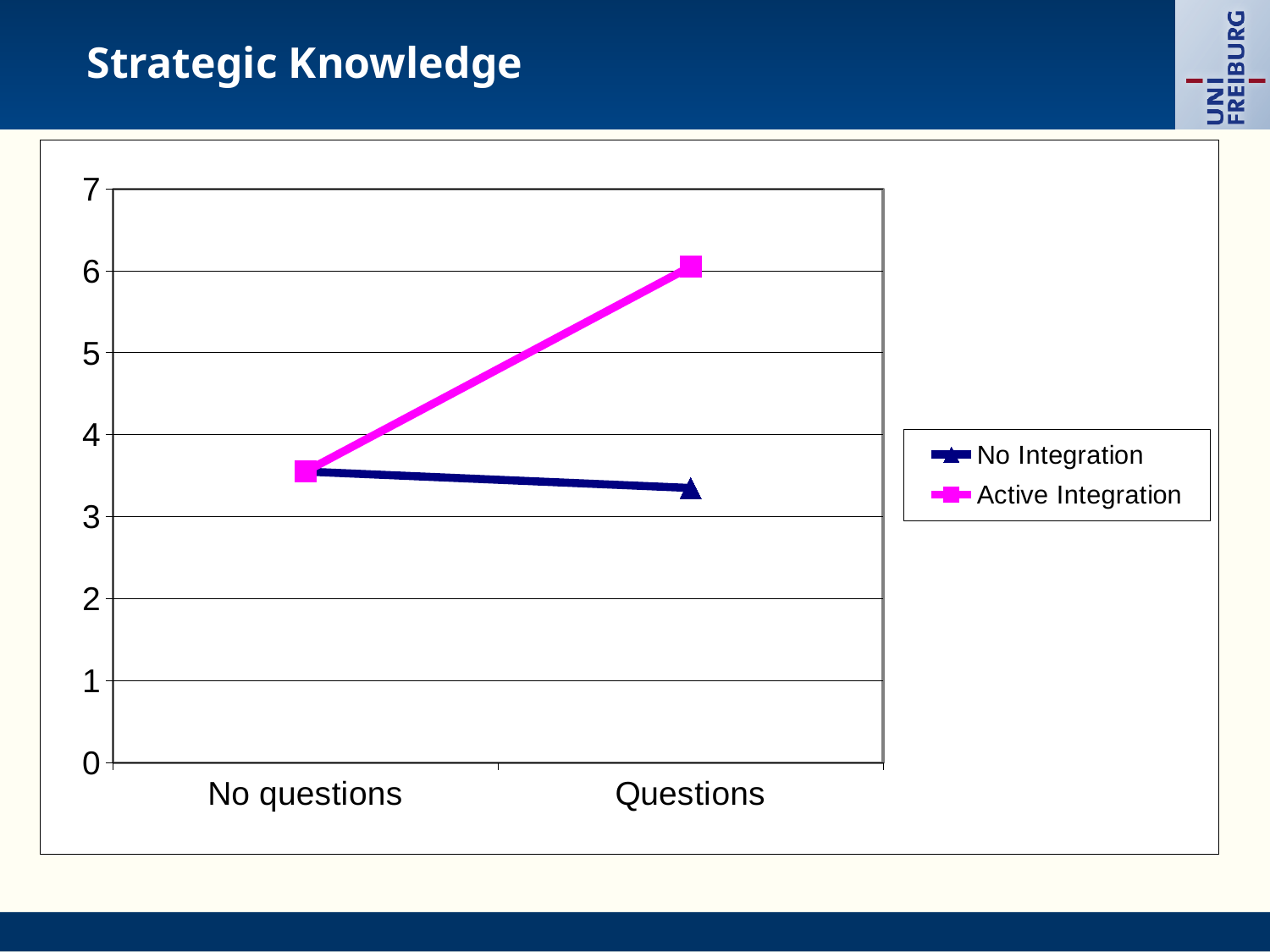
How many categories are shown on the x axis? 2 For the Active Integration series, which category has the highest value? Questions What is the title of the slide containing the chart? Strategic Knowledge Is the value for Active Integration at Questions greater or less than 5? greater What kind of chart is shown on the slide? line chart How many series does the legend list? 2 Is the value for No Integration at No questions greater or less than 4? less At Questions, which series has the larger value, No Integration or Active Integration? Active Integration Is the value for No Integration at Questions greater or less than 4? less Does the Active Integration line rise or fall from No questions to Questions? rise What are the two series named in the legend? No Integration and Active Integration